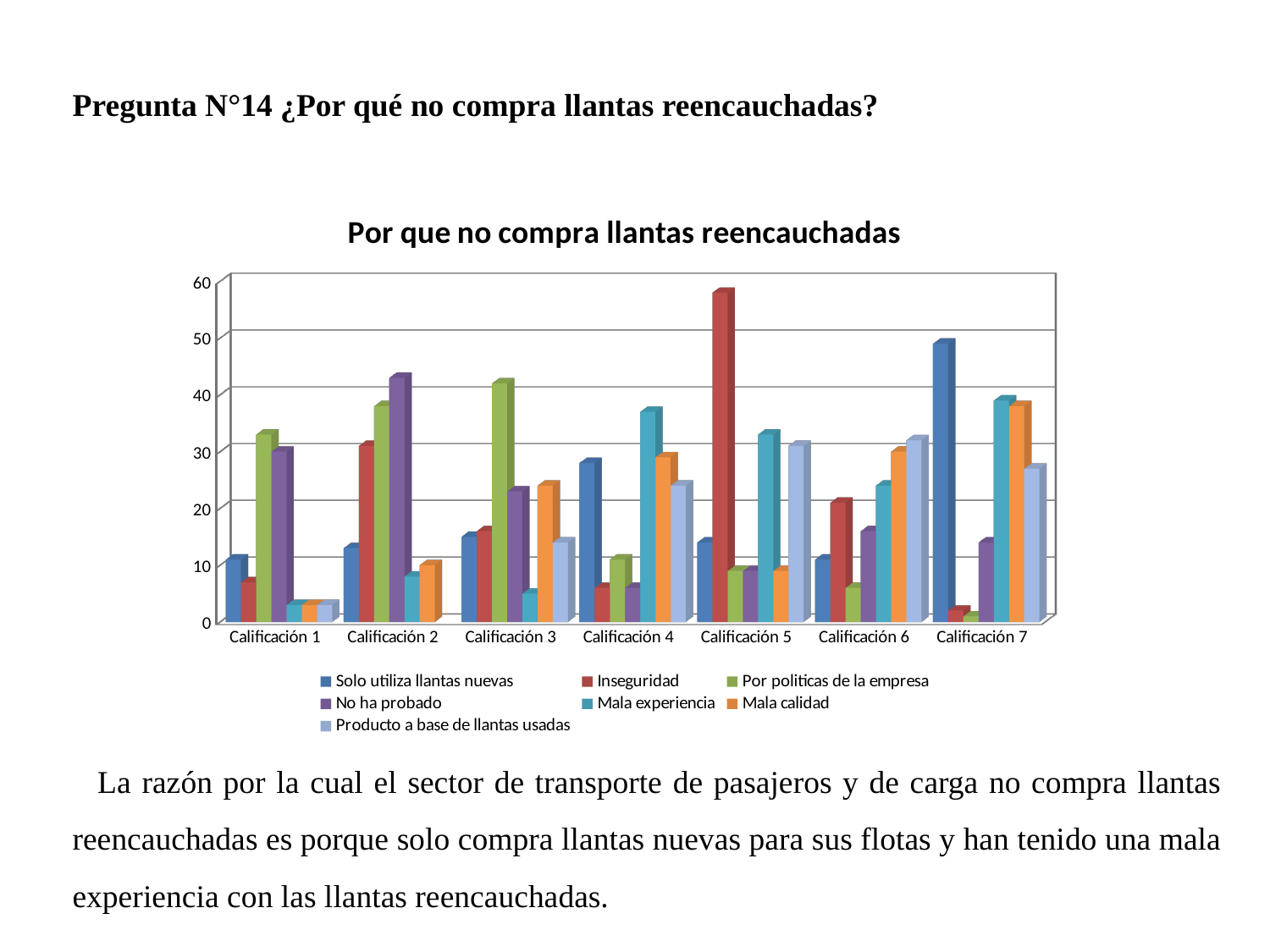
Is the value for Inseguridad in Calificación 5 greater or less than 50? greater Is the value for Mala experiencia in Calificación 4 greater or less than 30? greater Is the value for Solo utiliza llantas nuevas in Calificación 7 greater or less than 40? greater In which category is the Inseguridad bar the highest? Calificación 5 What kind of chart is shown on the slide? Bar chart How many categories (Calificación groups) are shown on the x axis? 7 In Calificación 6, which is larger: Mala calidad or Por politicas de la empresa? Mala calidad What is the title of the chart? Por que no compra llantas reencauchadas Which series has the highest bar in Calificación 7? Solo utiliza llantas nuevas In which category is the Solo utiliza llantas nuevas bar the highest? Calificación 7 How many series does the legend list? 7